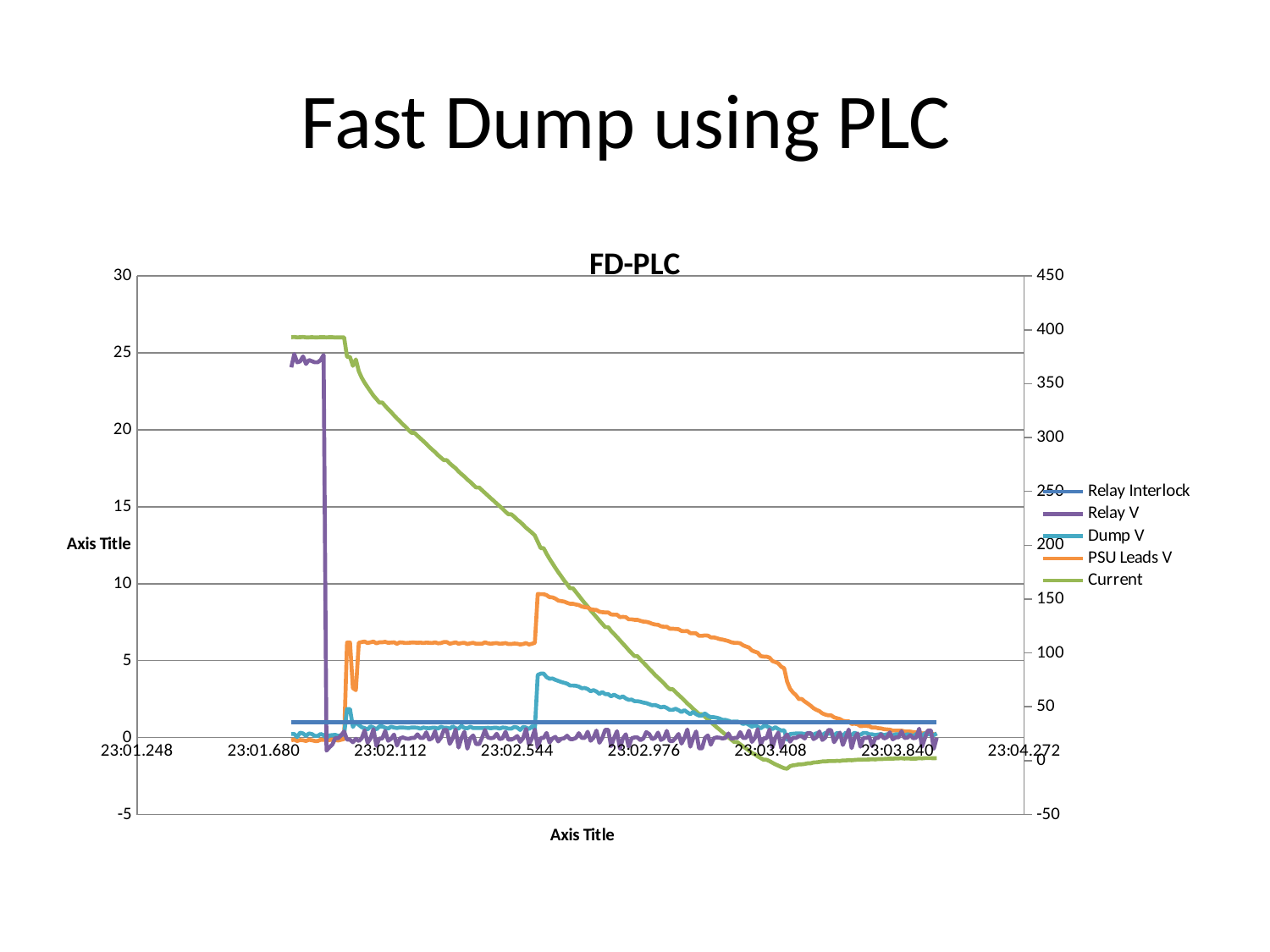
Is the value of the Relay Interlock series on the left axis greater or less than 5? less What kind of chart is shown on the slide? line chart How many series does the legend list? 5 Is the peak value of the Dump V series on the left axis greater or less than 5? less Which series is drawn in green in the legend? Current Is the peak value of the Current series on the right axis greater or less than 350? greater What is the minimum value shown on the left vertical axis? -5 What is the title of the chart? FD-PLC What is the maximum value shown on the right vertical axis? 450 Does the Current series rise or fall along the x axis after its initial plateau? fall